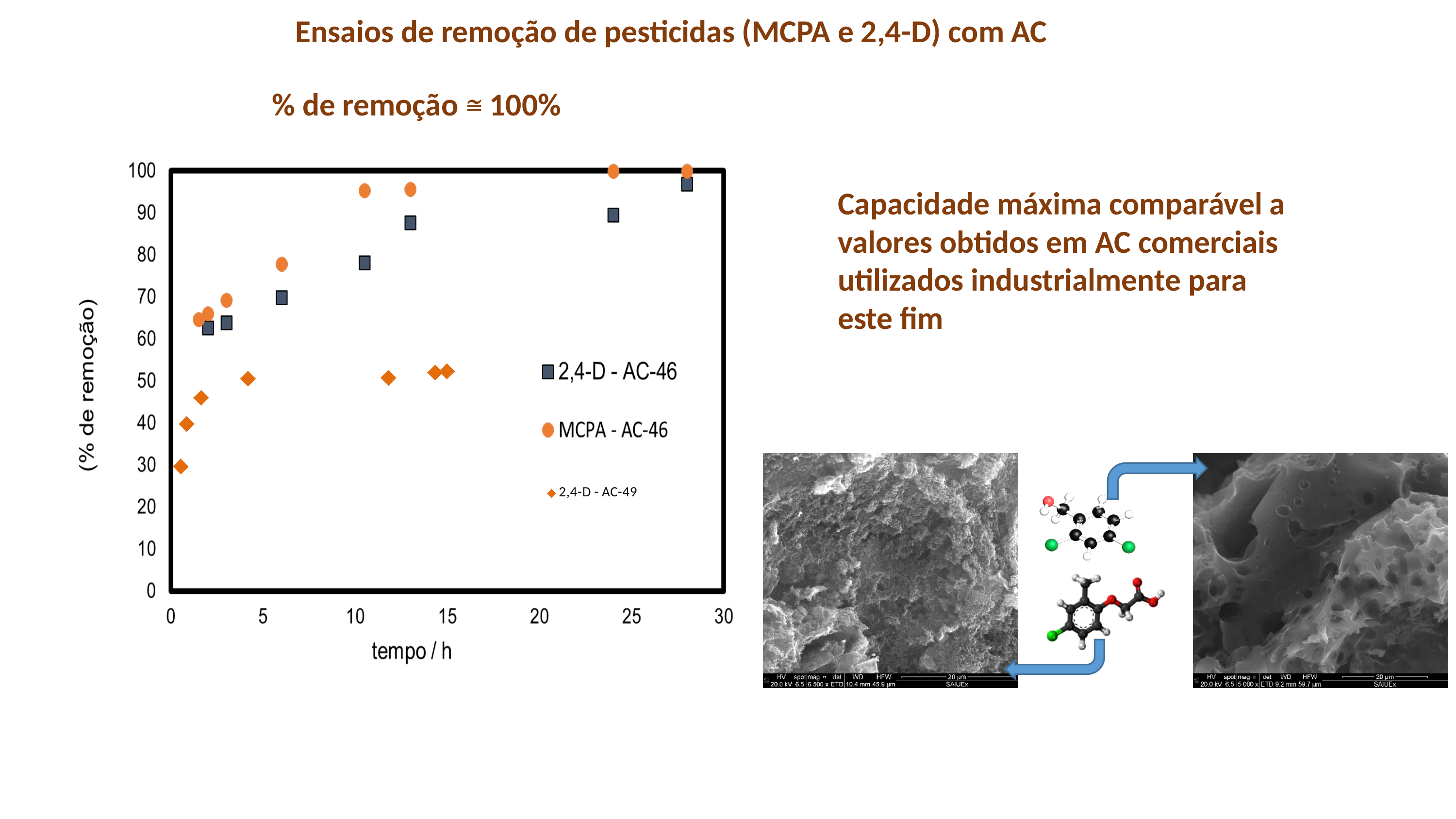
Do the values for MCPA - AC-46 rise or fall as time increases? rise Is the value for 2,4-D - AC-49 at about 15 h greater or less than 60? less Which series is plotted with orange diamond markers? 2,4-D - AC-49 Which series has the lowest removal values across the chart? 2,4-D - AC-49 Is the value for MCPA - AC-46 at about 6 h greater or less than 70? greater How many series does the chart legend list? 3 Is the value for MCPA - AC-46 at about 24 h greater or less than 90? greater What is the label of the x axis of the chart? tempo / h What kind of chart is shown on the slide? scatter chart At about 13 h, which is larger: the value for MCPA - AC-46 or the value for 2,4-D - AC-46? MCPA - AC-46